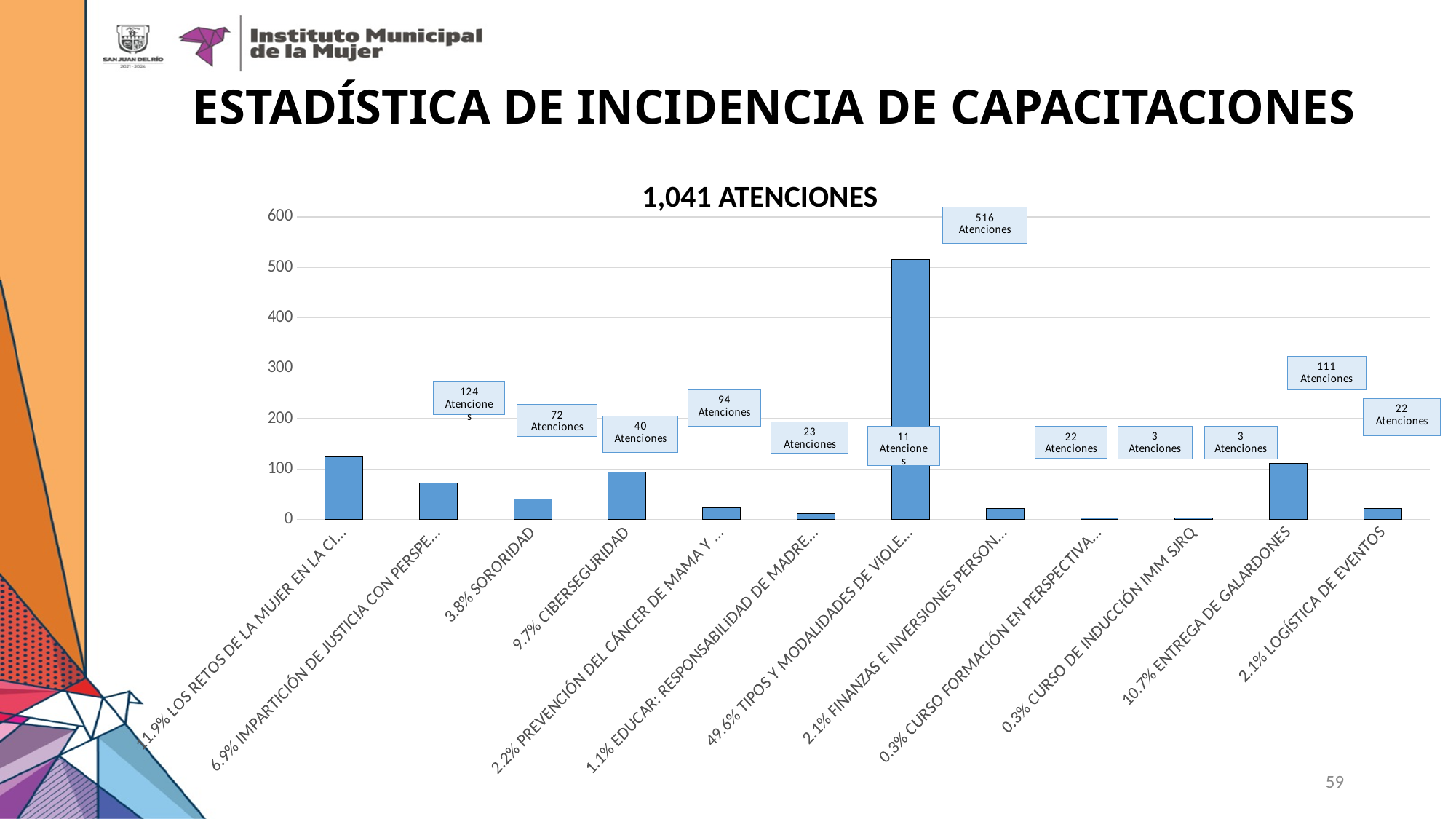
How many atenciones are shown for LOGÍSTICA DE EVENTOS? 22 Atenciones Is the value for CURSO DE INDUCCIÓN IMM SJRQ greater or less than 100? less How many atenciones are shown for ENTREGA DE GALARDONES? 111 Atenciones What is the title of the chart? 1,041 ATENCIONES How many atenciones are shown for CIBERSEGURIDAD? 94 Atenciones Which has more atenciones, SORORIDAD or CIBERSEGURIDAD? CIBERSEGURIDAD How many categories (bars) does the chart show? 12 What is the value of the tallest bar in the chart? 516 Atenciones What type of chart is shown on the slide? Bar chart How many atenciones are shown for SORORIDAD? 40 Atenciones Which category has the highest number of atenciones? 49.6% TIPOS Y MODALIDADES DE VIOLE... What is the difference in atenciones between ENTREGA DE GALARDONES and CIBERSEGURIDAD? 17